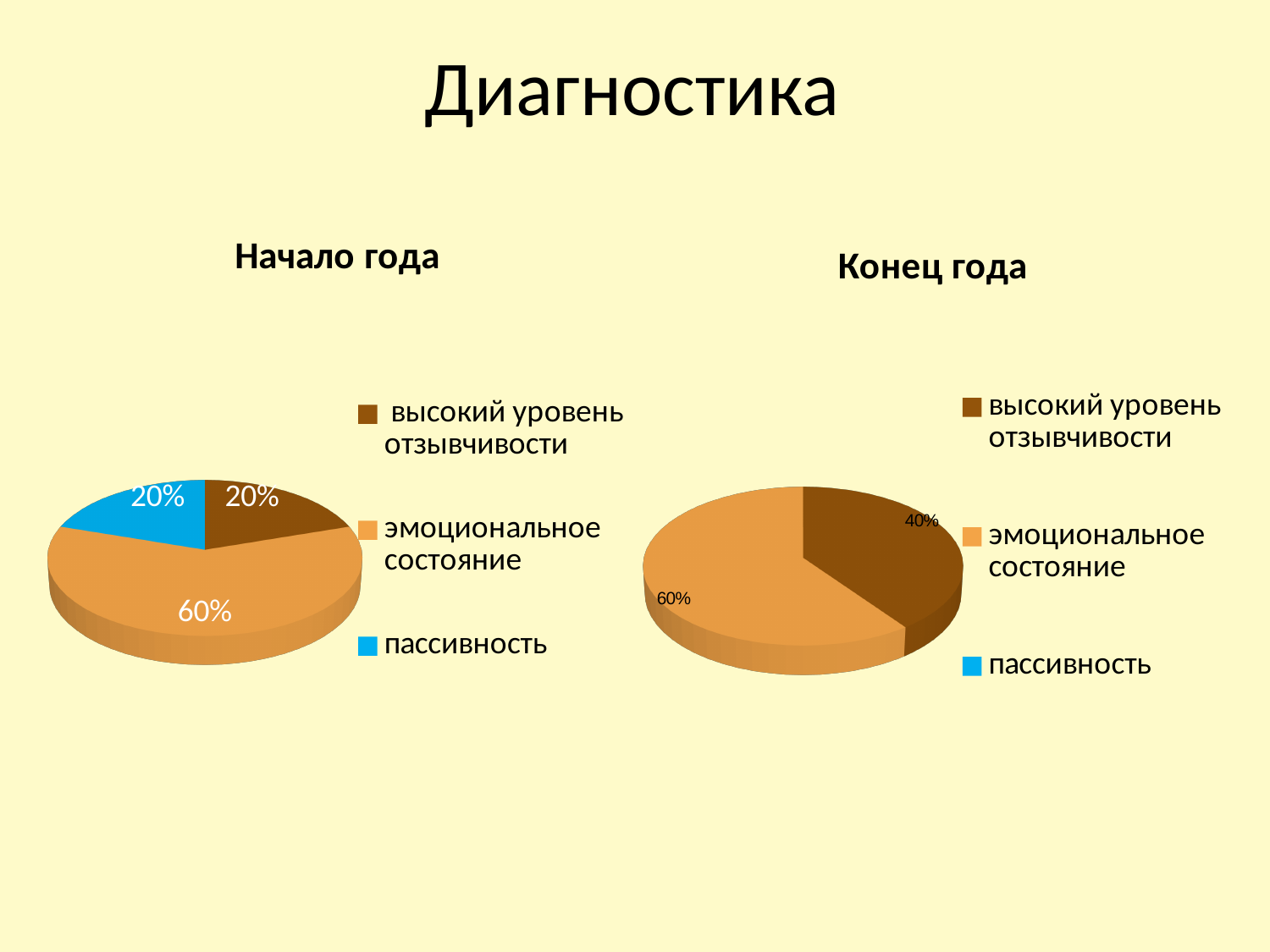
In the "Конец года" chart, what is the difference between the "эмоциональное состояние" and "высокий уровень отзывчивости" shares? 20% In the "Начало года" chart, what share does "высокий уровень отзывчивости" have? 20% In the "Конец года" chart, what share does "высокий уровень отзывчивости" have? 40% In the "Начало года" chart, what colour is the "пассивность" slice? blue In the "Начало года" chart, what share does "пассивность" have? 20% How many entries does the legend of the "Начало года" chart list? 3 In the "Начало года" chart, what share does "эмоциональное состояние" have? 60% Which chart shows a larger share for "высокий уровень отзывчивости", "Начало года" or "Конец года"? Конец года What kind of chart is the "Начало года" chart? pie chart In the "Конец года" chart, which category has the largest slice? эмоциональное состояние In the "Конец года" chart, what share does "эмоциональное состояние" have? 60% In the "Начало года" chart, which category has the largest slice? эмоциональное состояние